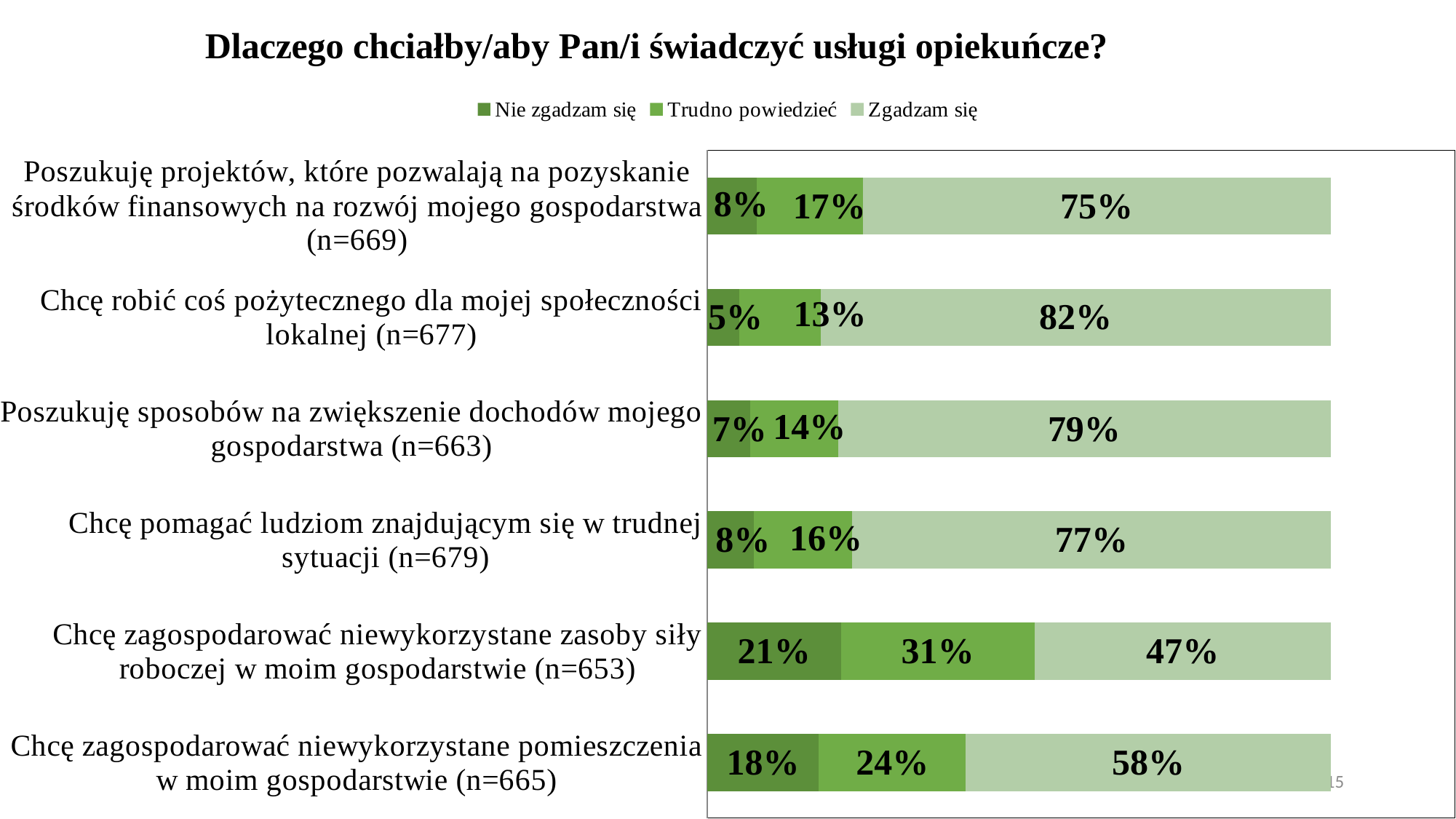
Which category has the lowest 'Zgadzam się' value? Chcę zagospodarować niewykorzystane zasoby siły roboczej w moim gospodarstwie (n=653) Which category has the highest 'Zgadzam się' value? Chcę robić coś pożytecznego dla mojej społeczności lokalnej (n=677) What is the title of the chart? Dlaczego chciałby/aby Pan/i świadczyć usługi opiekuńcze? What is the 'Trudno powiedzieć' value for 'Poszukuję sposobów na zwiększenie dochodów mojego gospodarstwa (n=663)'? 14% What is the 'Zgadzam się' value for 'Chcę robić coś pożytecznego dla mojej społeczności lokalnej (n=677)'? 82% Which is larger: the 'Trudno powiedzieć' value for 'Poszukuję projektów, które pozwalają na pozyskanie środków finansowych na rozwój mojego gospodarstwa (n=669)' or for 'Chcę pomagać ludziom znajdującym się w trudnej sytuacji (n=679)'? Poszukuję projektów, które pozwalają na pozyskanie środków finansowych na rozwój mojego gospodarstwa (n=669) How many series does the legend list? 3 What is the difference between the 'Zgadzam się' values for 'Chcę pomagać ludziom znajdującym się w trudnej sytuacji (n=679)' and 'Chcę zagospodarować niewykorzystane pomieszczenia w moim gospodarstwie (n=665)'? 19% What is the 'Nie zgadzam się' value for 'Chcę zagospodarować niewykorzystane zasoby siły roboczej w moim gospodarstwie (n=653)'? 21% How many categories (statements) are plotted in the chart? 6 What kind of chart is shown on the slide? Stacked bar chart What is the total of the stacked bar for 'Chcę zagospodarować niewykorzystane pomieszczenia w moim gospodarstwie (n=665)'? 100%